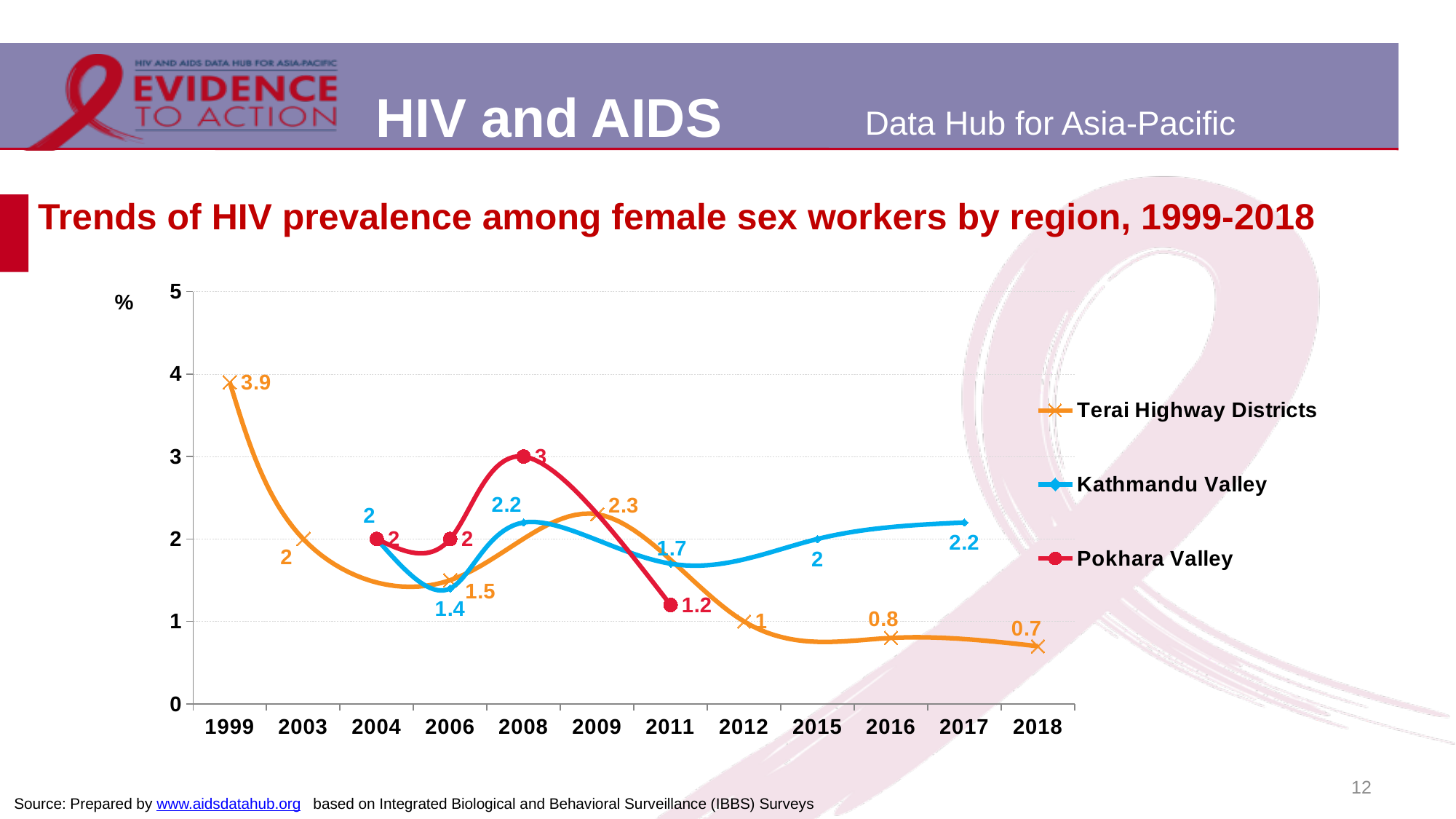
In which year did the Kathmandu Valley series reach its lowest value? 2006 What kind of chart is shown on the slide? Line chart In which year did the Terai Highway Districts series reach its highest value? 1999 In 2011, which series had the higher value: Kathmandu Valley or Pokhara Valley? Kathmandu Valley What was the HIV prevalence among female sex workers in the Terai Highway Districts in 1999? 3.9 Does the Terai Highway Districts series rise or fall between 2009 and 2018? Fall How many series does the legend list? 3 What is the difference between the Terai Highway Districts values in 1999 and 2018? 3.2 What value is shown for Kathmandu Valley in 2017? 2.2 How many years are shown on the x axis? 12 What value is shown for the Terai Highway Districts in 2018? 0.7 What value is shown for Pokhara Valley in 2008? 3